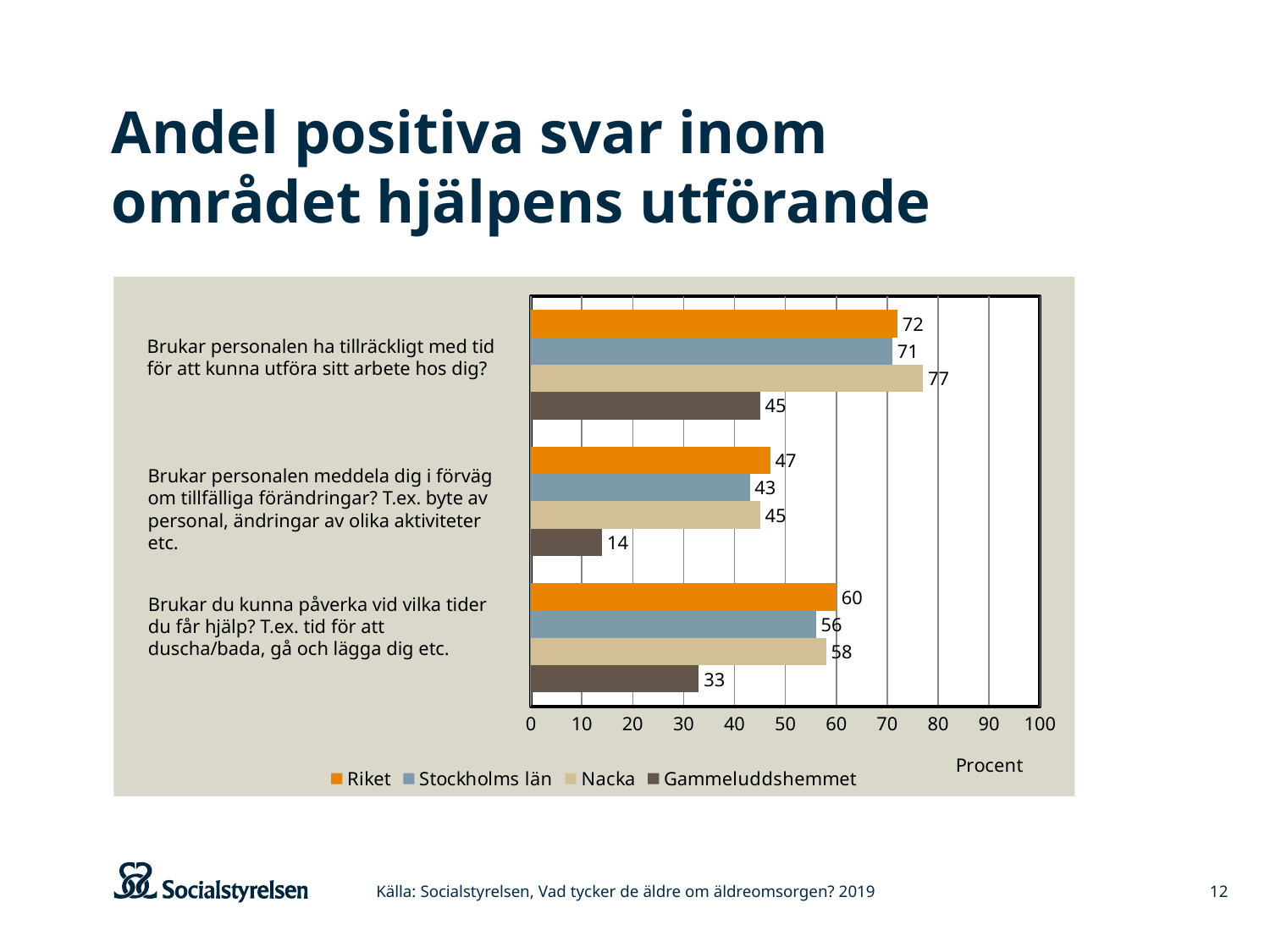
What is the value for Stockholms län on the question "Brukar personalen ha tillräckligt med tid för att kunna utföra sitt arbete hos dig?" 71 What is the value for Riket on the question "Brukar du kunna påverka vid vilka tider du får hjälp?" 60 What is the difference between the Nacka and Gammeluddshemmet values on the question "Brukar personalen ha tillräckligt med tid för att kunna utföra sitt arbete hos dig?" 32 How many series does the legend list? 4 Which series has the lowest value on the question "Brukar du kunna påverka vid vilka tider du får hjälp?" Gammeluddshemmet What is the value for Nacka on the question "Brukar personalen ha tillräckligt med tid för att kunna utföra sitt arbete hos dig?" 77 What kind of chart is shown on the slide? Bar chart What is the difference between the Riket and Stockholms län values on the question "Brukar du kunna påverka vid vilka tider du får hjälp?" 4 How many question categories are shown on the chart? 3 On the question "Brukar personalen meddela dig i förväg om tillfälliga förändringar?", which is larger: the value for Riket or the value for Nacka? Riket What is the value for Gammeluddshemmet on the question "Brukar personalen meddela dig i förväg om tillfälliga förändringar?" 14 Which series has the highest value on the question "Brukar personalen ha tillräckligt med tid för att kunna utföra sitt arbete hos dig?" Nacka